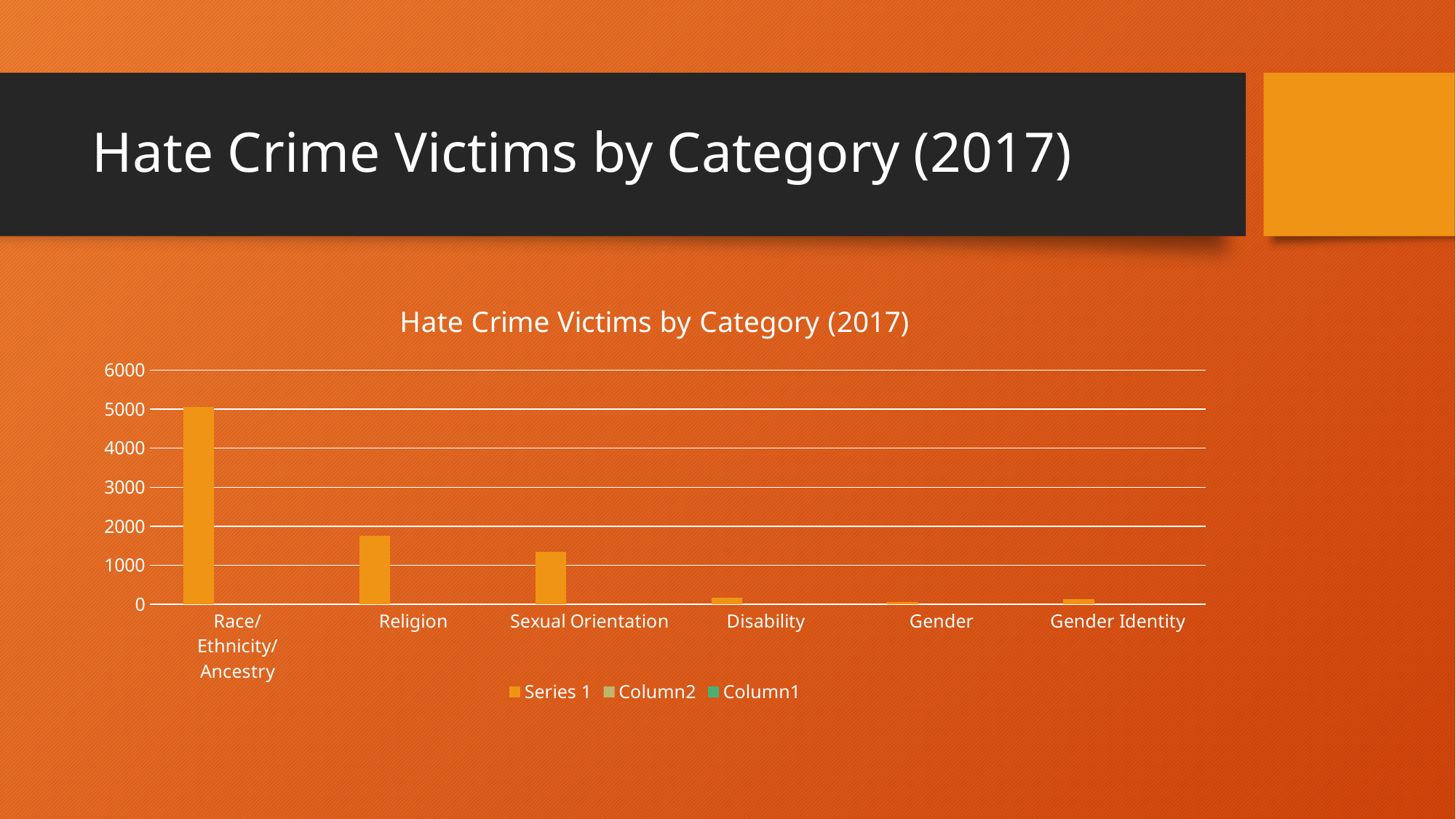
What kind of chart is shown on the slide? bar chart Which has more hate crime victims, Religion or Sexual Orientation? Religion How many series does the chart legend list? 3 Is the value for Disability greater or less than 1000? less Is the value for Religion greater or less than 2000? less How many categories are shown on the x axis of the chart? 6 Is the value for Race/Ethnicity/Ancestry greater or less than 4000? greater What is the title of the chart? Hate Crime Victims by Category (2017) Which category has the lowest number of hate crime victims? Gender What is the name of the first series listed in the legend? Series 1 Which category has the highest number of hate crime victims? Race/Ethnicity/Ancestry